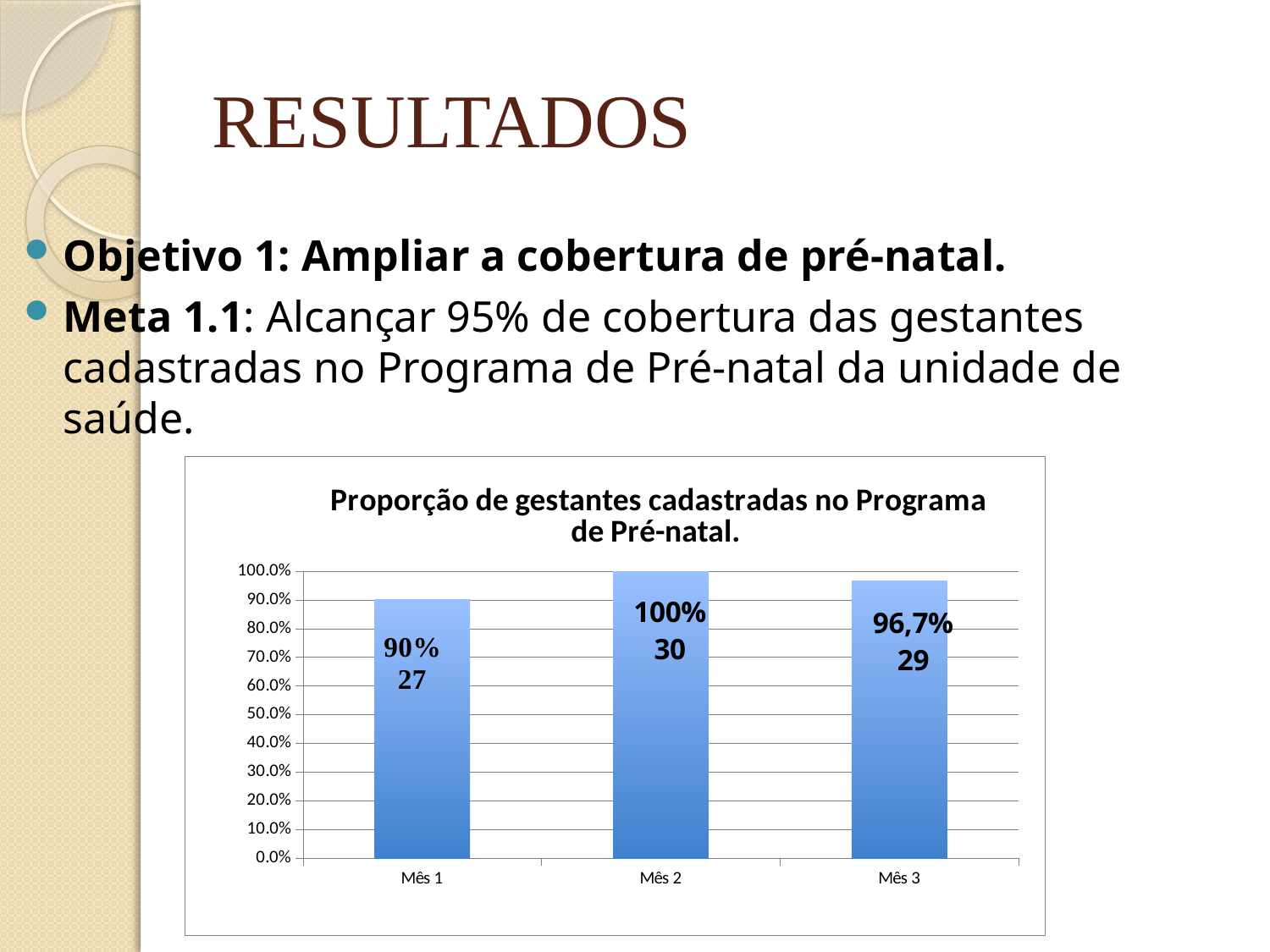
What is the difference in percentage points between Mês 2 and Mês 1? 10 Which month has the lowest proportion? Mês 1 What is the percentage shown for Mês 3? 96,7% What is the percentage shown for Mês 2? 100% What count is printed on the bar for Mês 1? 27 How many months are shown on the x axis? 3 What count is printed on the bar for Mês 3? 29 What is the title of the chart? Proporção de gestantes cadastradas no Programa de Pré-natal. What kind of chart is shown on the slide? Bar chart Which month has the highest proportion? Mês 2 What is the percentage shown for Mês 1? 90% Which is larger, the value for Mês 3 or the value for Mês 1? Mês 3